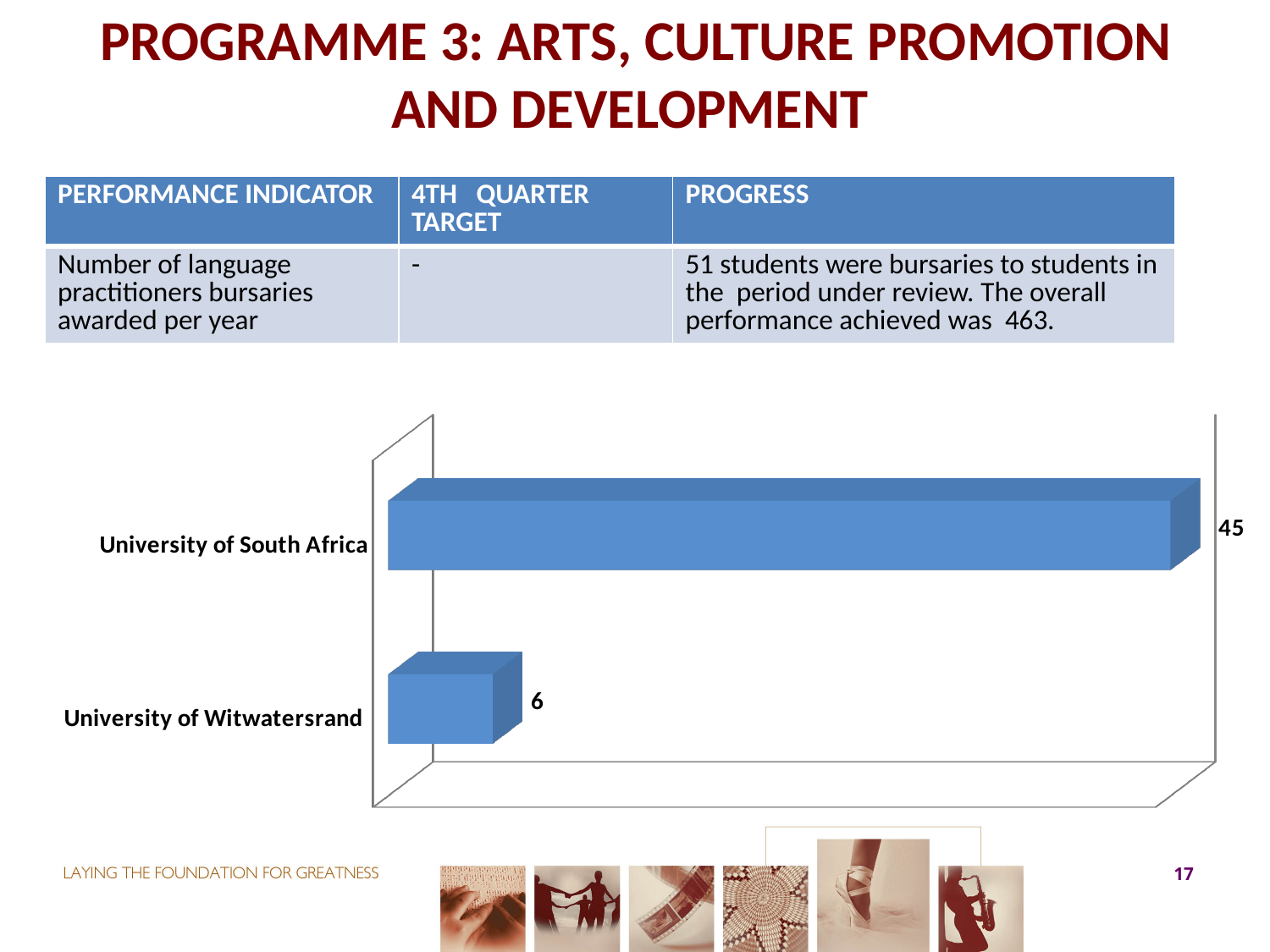
Which category has the lowest value? University of Witwatersrand What kind of chart is shown on the slide? bar chart Which is larger, the value for University of South Africa or the value for University of Witwatersrand? University of South Africa What is the difference between the values for University of South Africa and University of Witwatersrand? 39 Are the bars in the chart horizontal or vertical? horizontal Which category has the highest value? University of South Africa How many categories are shown in the chart? 2 What is the value for University of South Africa? 45 What is the value for University of Witwatersrand? 6 What is the total of the two values shown in the chart? 51 What colour are the bars in the chart? blue